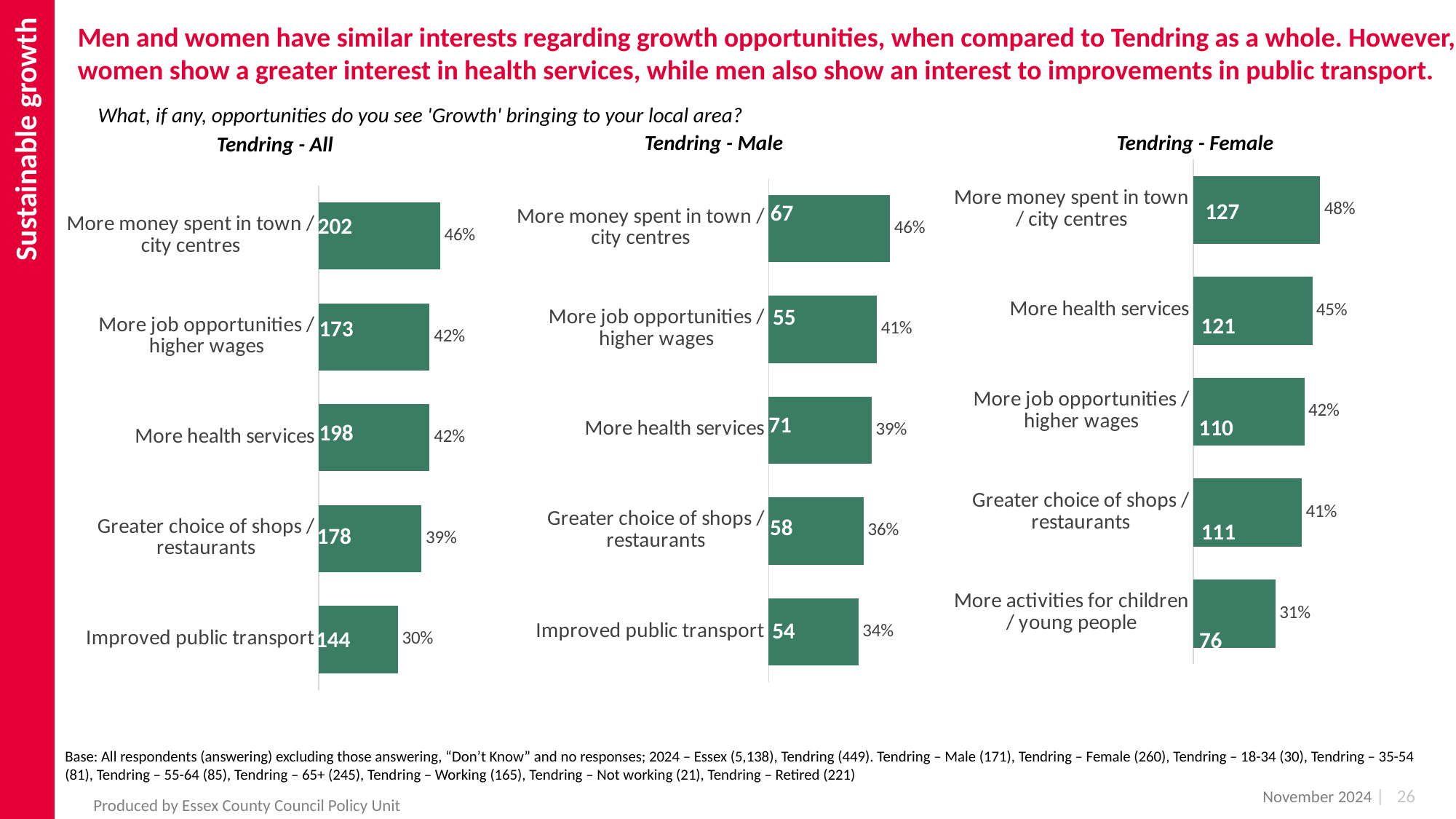
In the Tendring - Male chart, which category has the lowest percentage? Improved public transport What kind of chart is the Tendring - All chart? Bar chart In the Tendring - Male chart, what percentage is shown for 'Improved public transport'? 34% How many charts are shown on the slide? 3 In the Tendring - All chart, what is the difference in count between 'More money spent in town / city centres' and 'Improved public transport'? 58 In the Tendring - All chart, what is the count for 'More money spent in town / city centres'? 202 In the Tendring - Female chart, which category has the highest percentage? More money spent in town / city centres In the Tendring - Female chart, what is the count for 'More health services'? 121 In the Tendring - Female chart, what percentage is shown for 'More activities for children / young people'? 31% How many categories are shown in the Tendring - Male chart? 5 In the Tendring - Female chart, which has a higher percentage: 'More health services' or 'Greater choice of shops / restaurants'? More health services In the Tendring - Male chart, what is the count for 'More health services'? 71